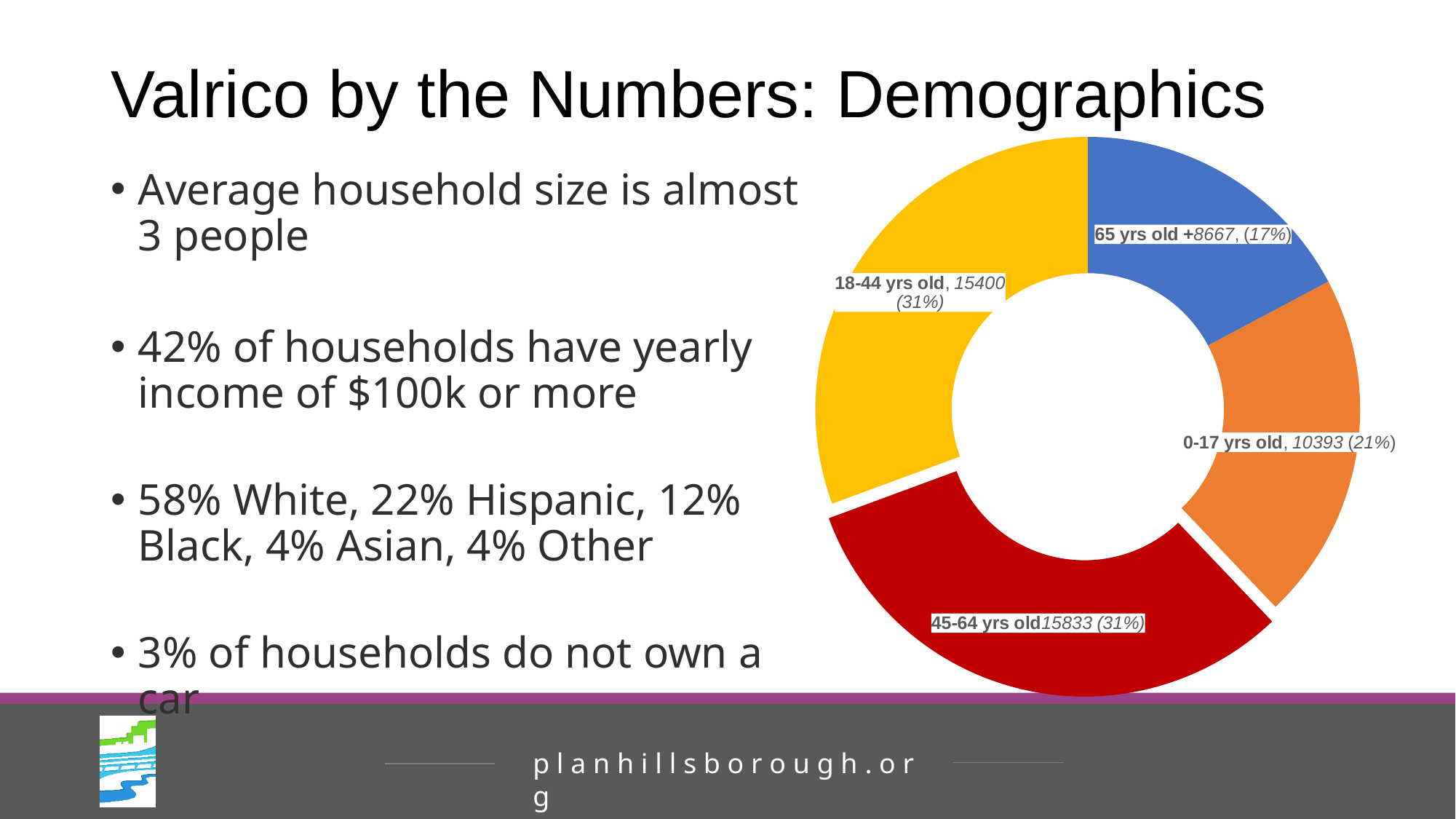
What is the value for the 18-44 yrs old category in the chart? 15400 Which age group has the highest value in the chart? 45-64 yrs old Which age group has the lowest value in the chart? 65 yrs old + What is the difference between the values for 0-17 yrs old and 65 yrs old +? 1726 How many age categories are shown in the chart? 4 What is the value for the 65 yrs old + category in the chart? 8667 What is the difference between the values for 45-64 yrs old and 18-44 yrs old? 433 What share of the chart does the 0-17 yrs old slice represent? 21% Which is larger, the value for 0-17 yrs old or the value for 65 yrs old +? 0-17 yrs old What kind of chart is shown on the slide? Doughnut (pie) chart What is the value for the 0-17 yrs old category in the chart? 10393 What colour is the 45-64 yrs old slice in the chart? Red